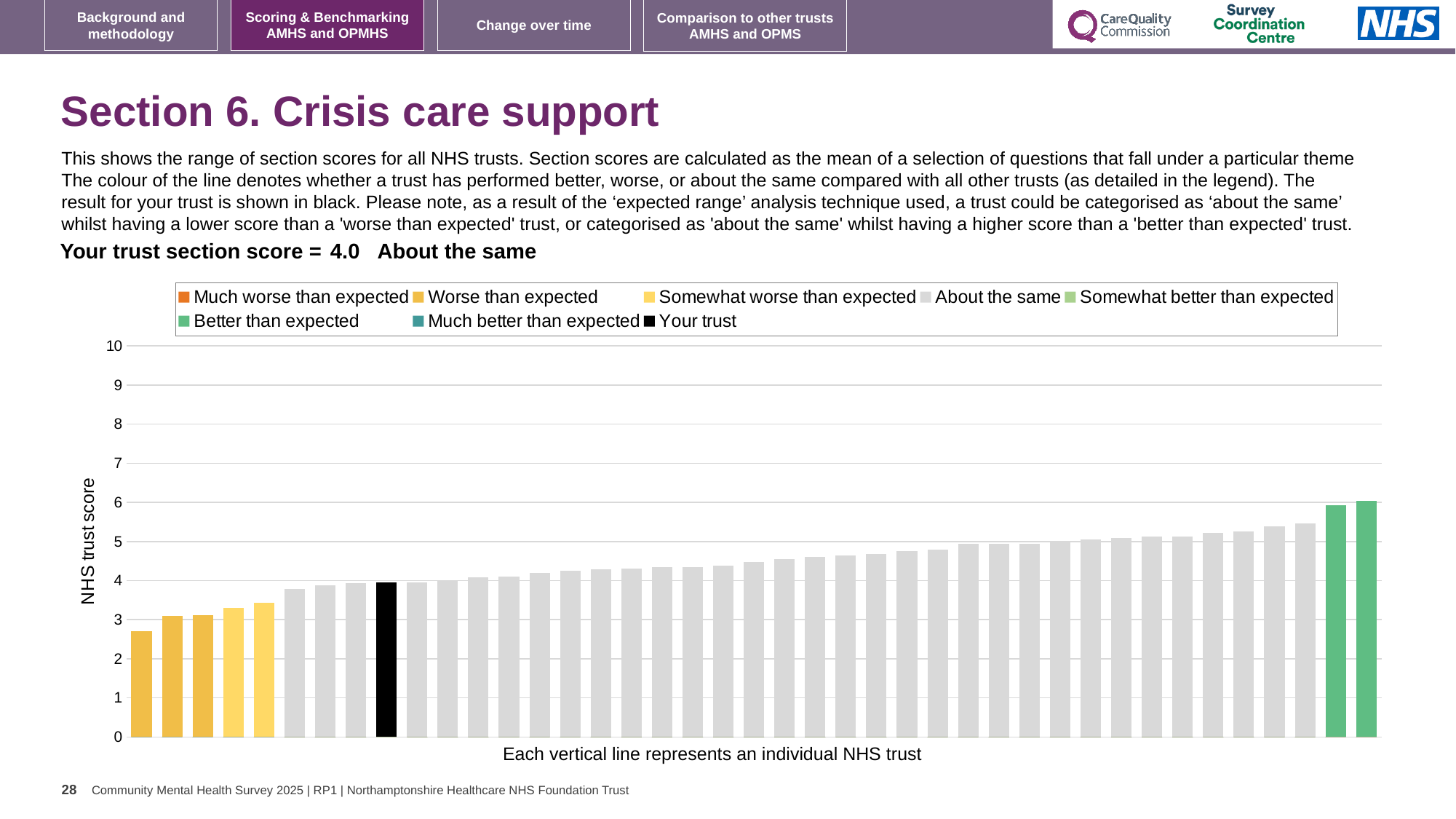
Is the value of the highest bar greater or less than 5? greater Do the bar values rise or fall from left to right along the x axis? rise What colour is the bar representing your trust? black How many entries does the chart legend list? 8 How many bars are coloured as 'Worse than expected' (dark yellow)? 3 How many bars are coloured as 'Better than expected' (green)? 2 What is the label on the vertical axis? NHS trust score What is the section score for your trust? 4.0 Is the value of the black bar (your trust) greater or less than 5? less What kind of chart is shown on the slide? bar chart Which category is your trust placed in for this section? About the same Is the value of the lowest bar greater or less than 3? less